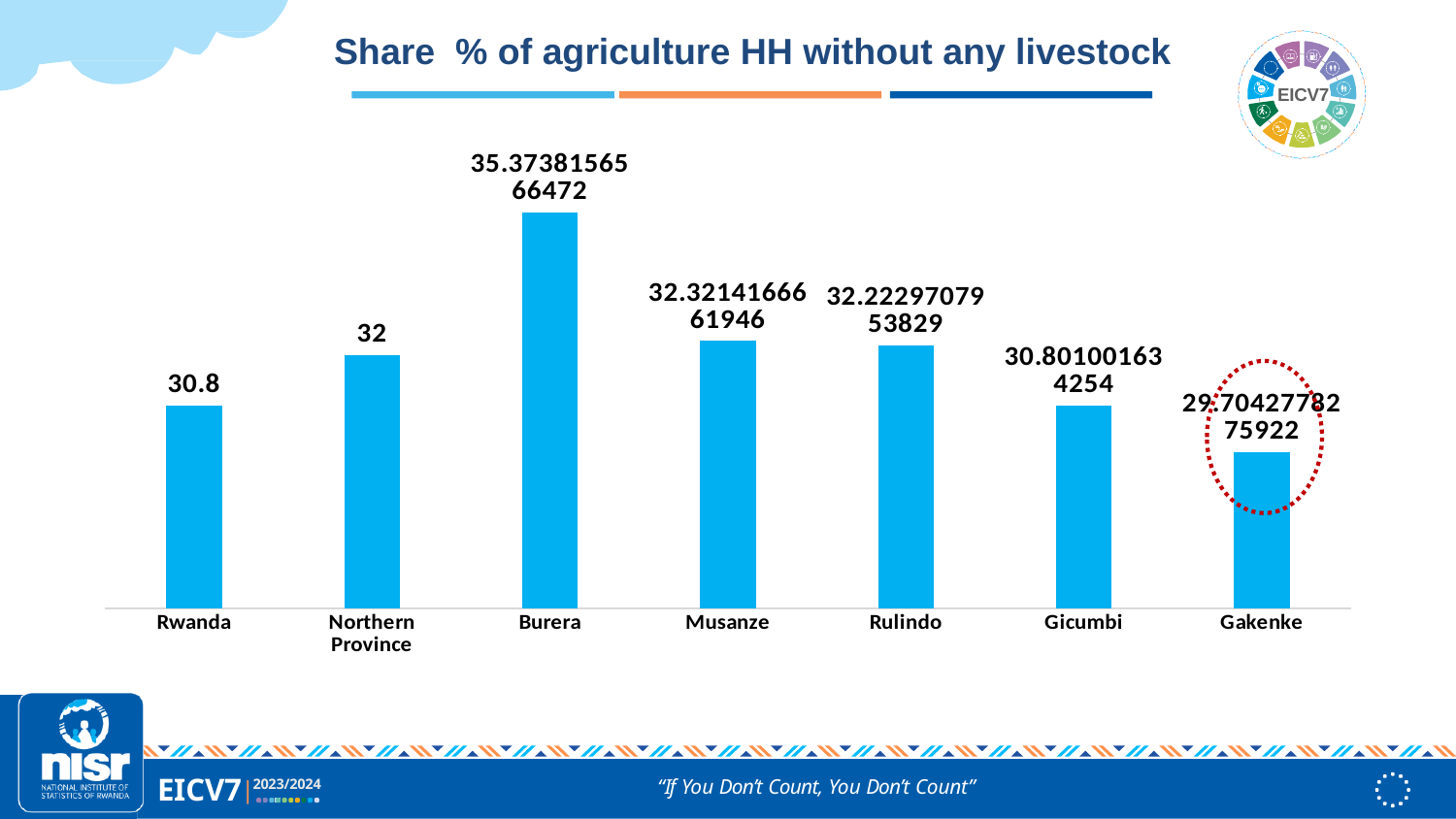
What is the value shown for Burera? 35.3738156566472 How many categories are shown on the x axis? 7 Which category has the highest value? Burera What is the value for Northern Province? 32 What is the value shown for Gakenke? 29.7042778275922 Which category has the lowest value? Gakenke What is the title of the chart? Share % of agriculture HH without any livestock What type of chart is shown on the slide? Bar chart Which category's bar and label are circled with a red dotted outline? Gakenke What is the difference between the values for Northern Province and Rwanda? 1.2 Which is larger, the value for Musanze or the value for Gicumbi? Musanze What is the value for Rwanda? 30.8